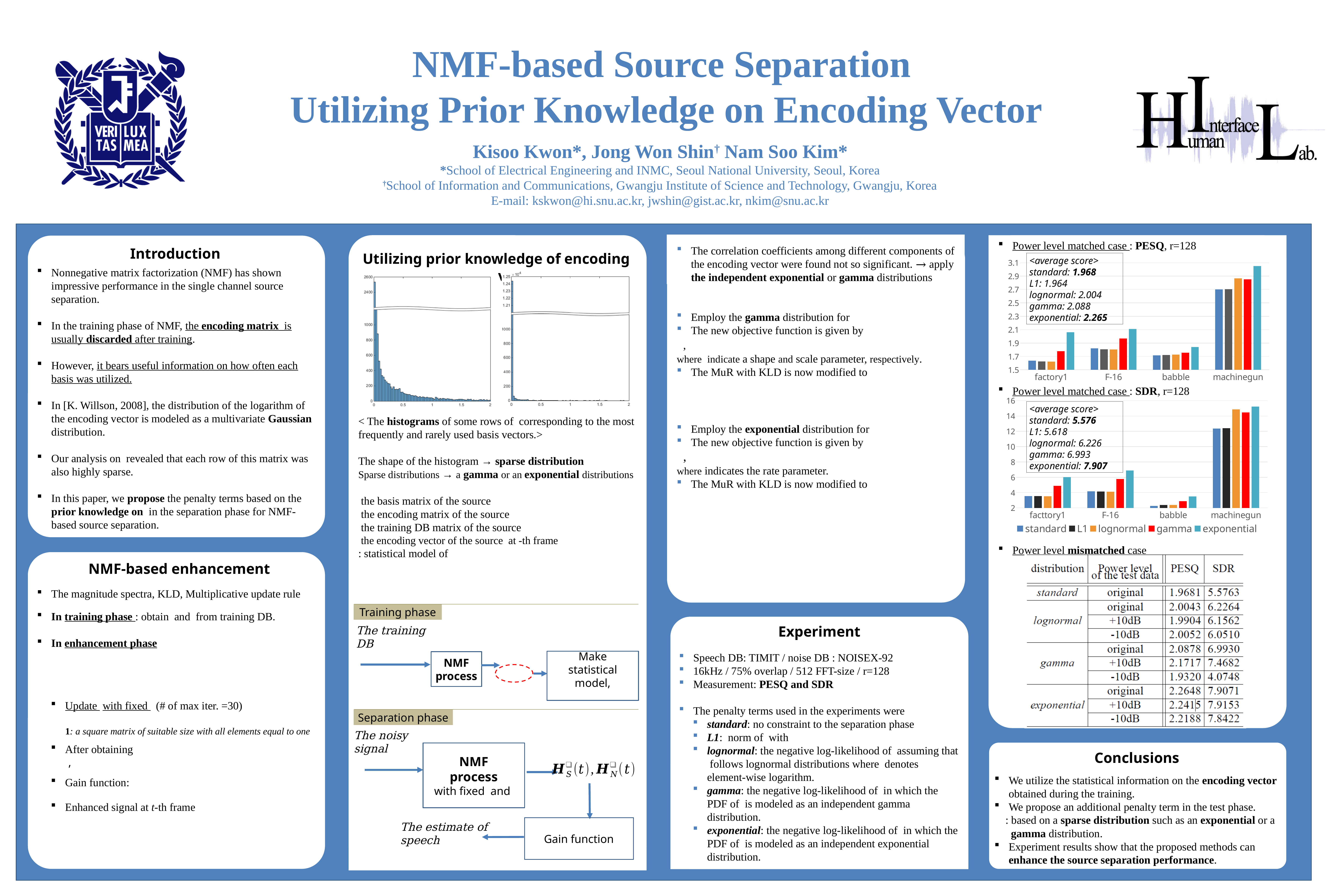
How many noise categories are shown on the x axis of the 'Power level matched case : PESQ, r=128' chart? 4 In the 'Power level matched case : SDR, r=128' chart, is the exponential value for machinegun greater or less than 14? greater In the 'Power level matched case : PESQ, r=128' chart, is the exponential value for factory1 greater or less than 1.9? greater In the 'Power level matched case : PESQ, r=128' chart, which noise category has the highest bars? machinegun In the 'Power level matched case : SDR, r=128' chart, which noise category has the lowest bars? babble What kind of chart is the 'Power level matched case : PESQ, r=128' chart? bar chart In the 'Power level matched case : SDR, r=128' chart, what is the average score listed for gamma? 6.993 In the 'Power level matched case : SDR, r=128' chart, is the standard value for babble greater or less than 4? less In the 'Power level matched case : PESQ, r=128' chart, which is larger for machinegun: the standard bar or the exponential bar? exponential How many series does the legend list for the 'Power level matched case : SDR, r=128' chart? 5 In the 'Power level matched case : PESQ, r=128' chart, what is the average score listed for exponential? 2.265 In the 'Power level matched case : SDR, r=128' chart, which colour represents the exponential series? light blue